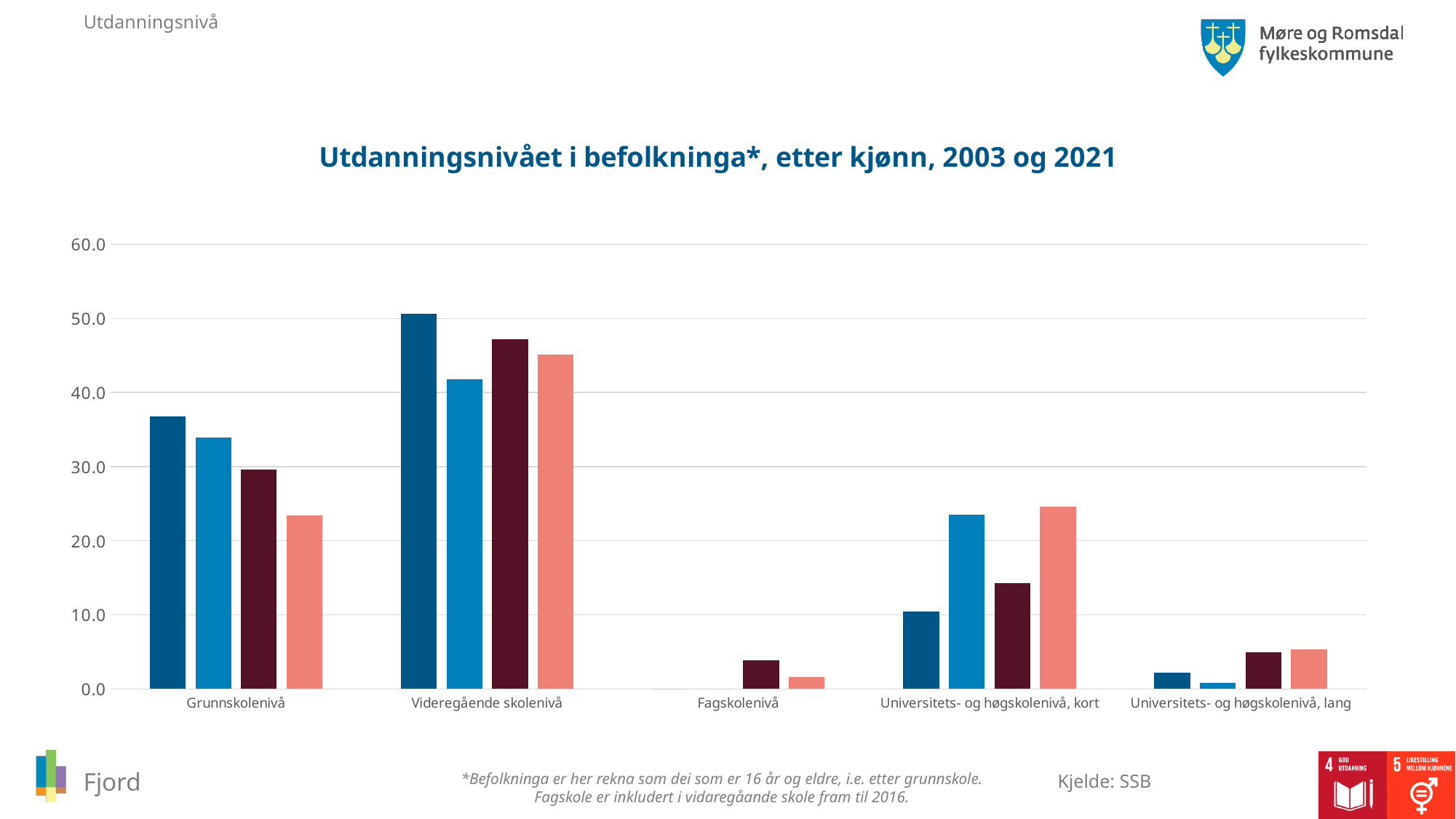
What is the title of the chart? Utdanningsnivået i befolkninga*, etter kjønn, 2003 og 2021 Which category has the tallest bar in the chart? Videregående skolenivå What kind of chart is shown on the slide? bar chart How many bars are plotted for each category? 4 How many education-level categories are shown on the x axis? 5 What source is cited for the chart? SSB Is the value of the dark blue bar for Videregående skolenivå greater or less than 40? greater Is the value of the salmon-coloured bar for Grunnskolenivå greater or less than 20? greater For Grunnskolenivå, which is taller: the dark blue bar or the salmon-coloured bar? the dark blue bar For Universitets- og høgskolenivå, kort, which is taller: the dark blue bar or the light blue bar? the light blue bar Is the value of the dark red bar for Fagskolenivå greater or less than 10? less Which category has the lowest bars overall? Fagskolenivå